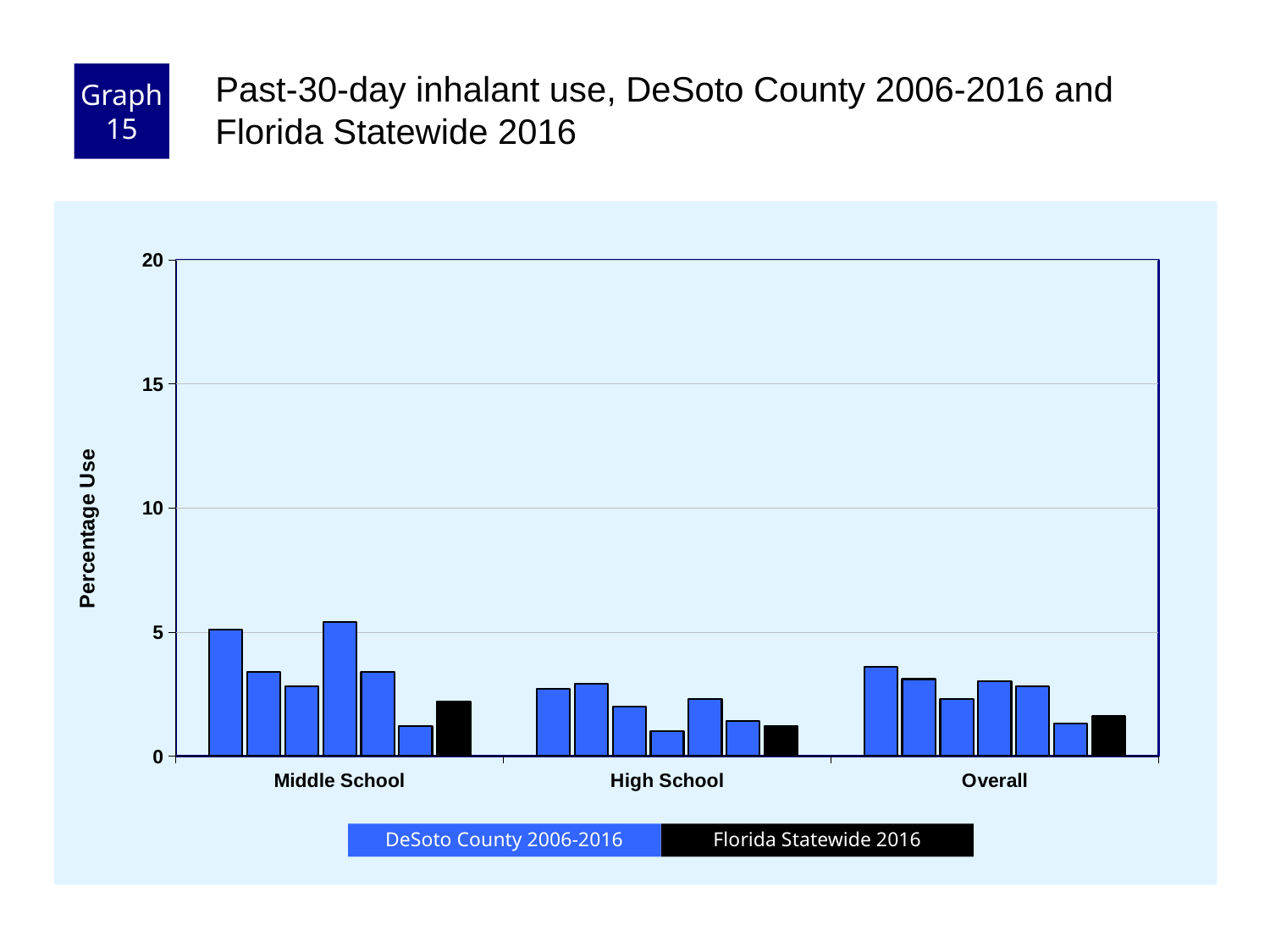
What is the label on the vertical axis of the chart? Percentage Use How many categories are shown on the x axis of the chart? 3 Which is larger, the Florida Statewide 2016 value for Middle School or for High School? Middle School How many series does the chart legend list? 2 Which category has the highest Florida Statewide 2016 value? Middle School Is the Florida Statewide 2016 value for Middle School greater or less than 5? less Which category has the lowest Florida Statewide 2016 value? High School What is the title of the chart? Past-30-day inhalant use, DeSoto County 2006-2016 and Florida Statewide 2016 Is the Florida Statewide 2016 value for Overall greater or less than 5? less What kind of chart is shown on the slide? bar chart Are any of the bars in the chart greater than 10? No